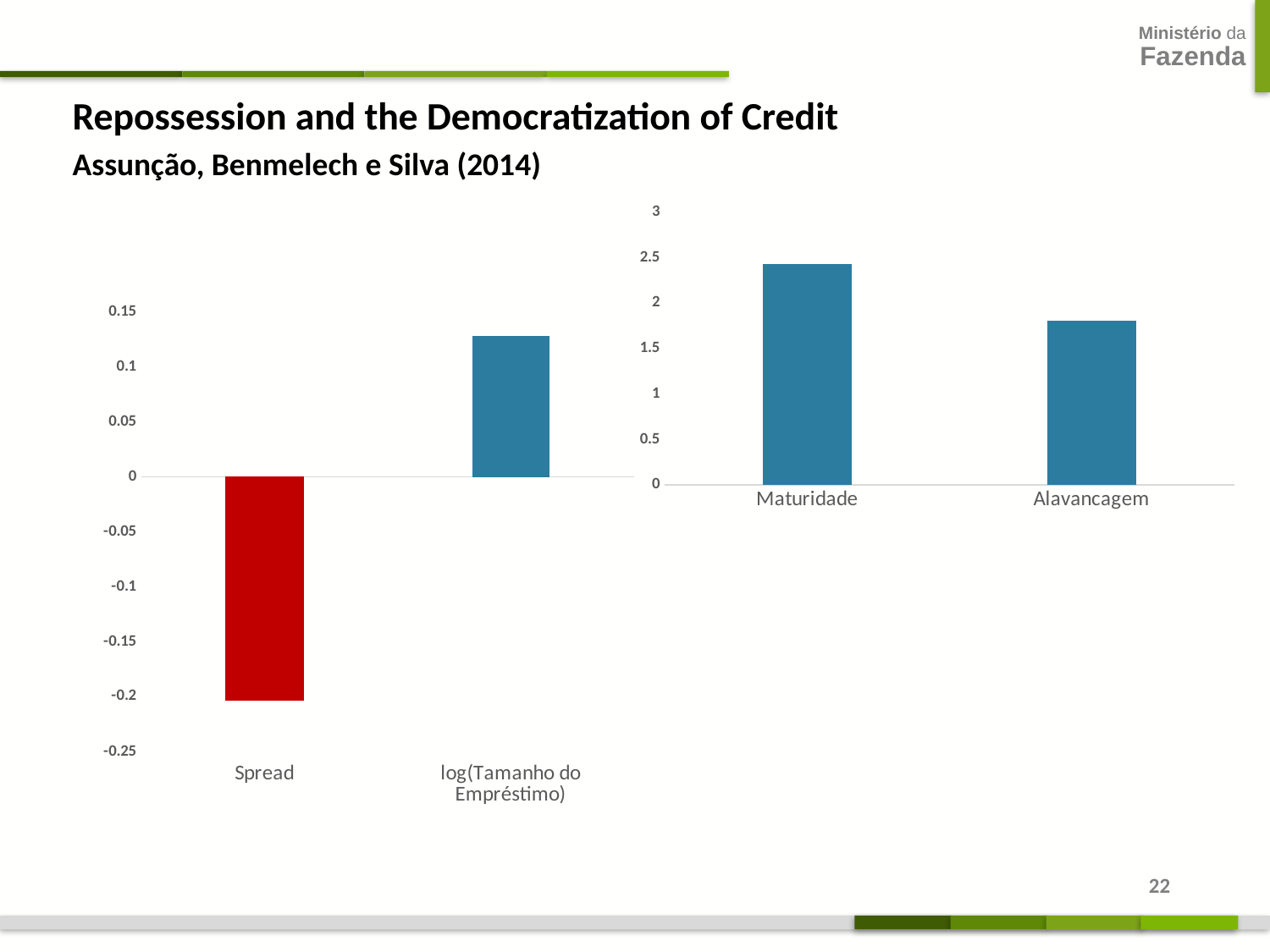
On the left chart, how many categories are plotted? 2 On the right chart, which category has the highest value? Maturidade On the left chart, is the value for log(Tamanho do Empréstimo) greater or less than 0.1? greater On the left chart, what colour is the bar for Spread? Red On the right chart, is the value for Maturidade greater or less than 2? greater On the left chart, which category has the lowest value? Spread On the left chart, is the value for Spread greater or less than 0? less On the right chart, which is larger, Maturidade or Alavancagem? Maturidade What type of chart is the right chart? Bar chart